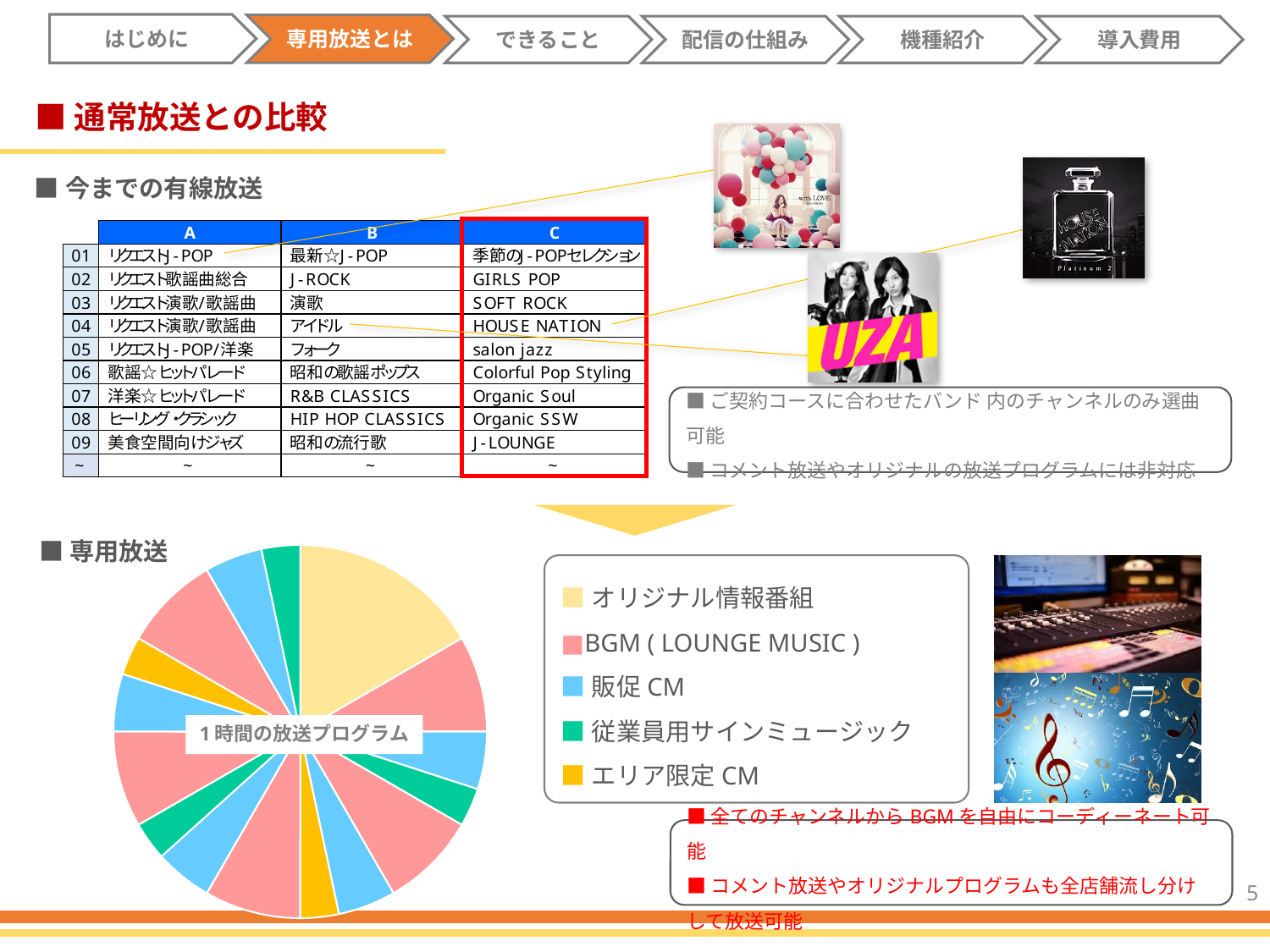
Which legend category has the largest single slice in the pie chart? オリジナル情報番組 Which colour represents BGM ( LOUNGE MUSIC ) in the pie chart legend? pink What kind of chart is shown under the heading 専用放送? pie chart What text is written in the centre of the pie chart? 1時間の放送プログラム How many categories does the legend of the pie chart list? 5